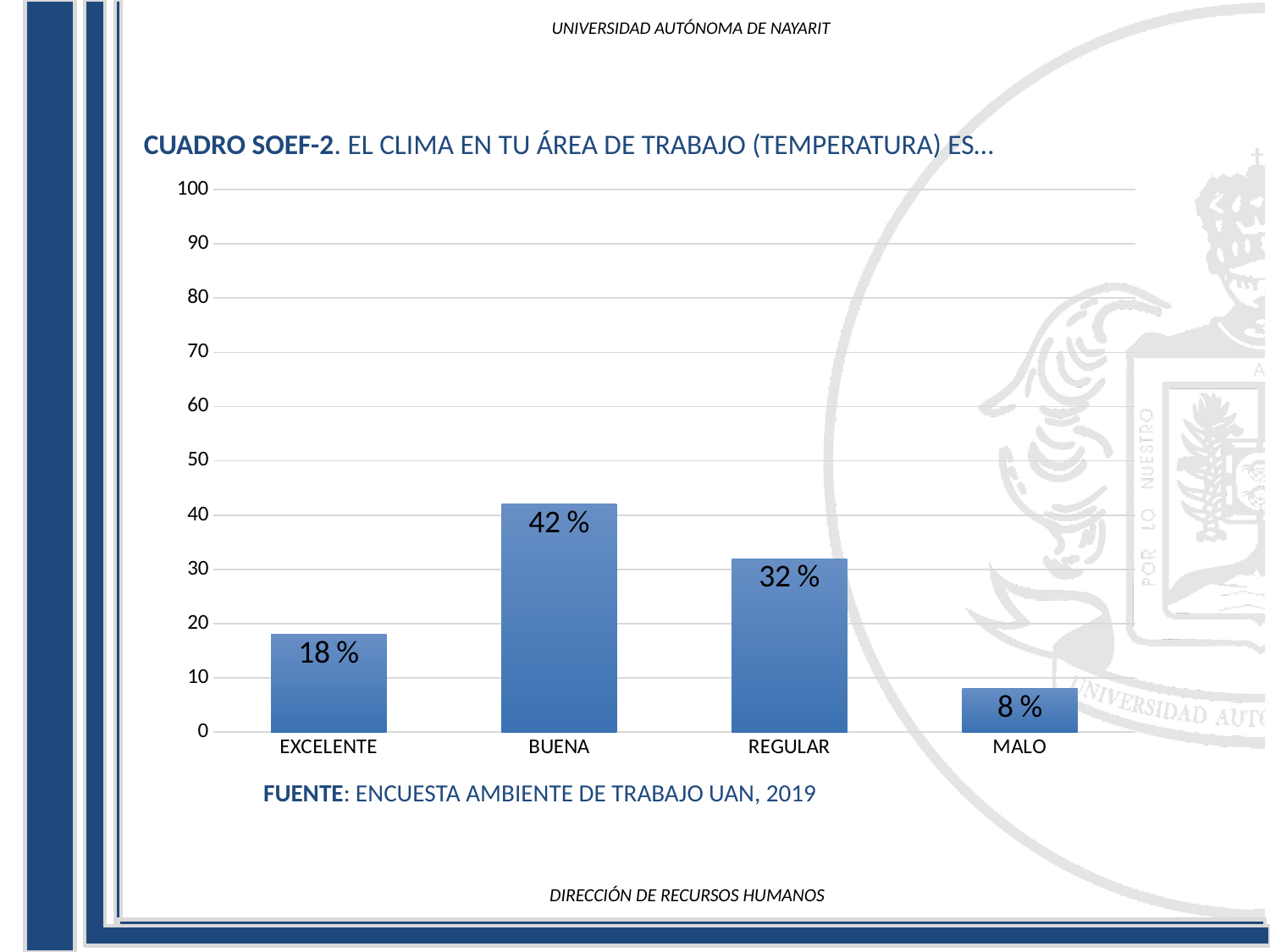
Which is larger, the value for EXCELENTE or the value for REGULAR? REGULAR What source is cited below the chart? ENCUESTA AMBIENTE DE TRABAJO UAN, 2019 What is the difference between the values for BUENA and REGULAR? 10 % What is the value for EXCELENTE? 18 % How many categories are shown on the x axis? 4 What is the value for BUENA? 42 % What is the value for REGULAR? 32 % Is the value for MALO greater or less than 10? less What is the value for MALO? 8 % Which category has the highest value? BUENA Which category has the lowest value? MALO What kind of chart is shown on the slide? bar chart